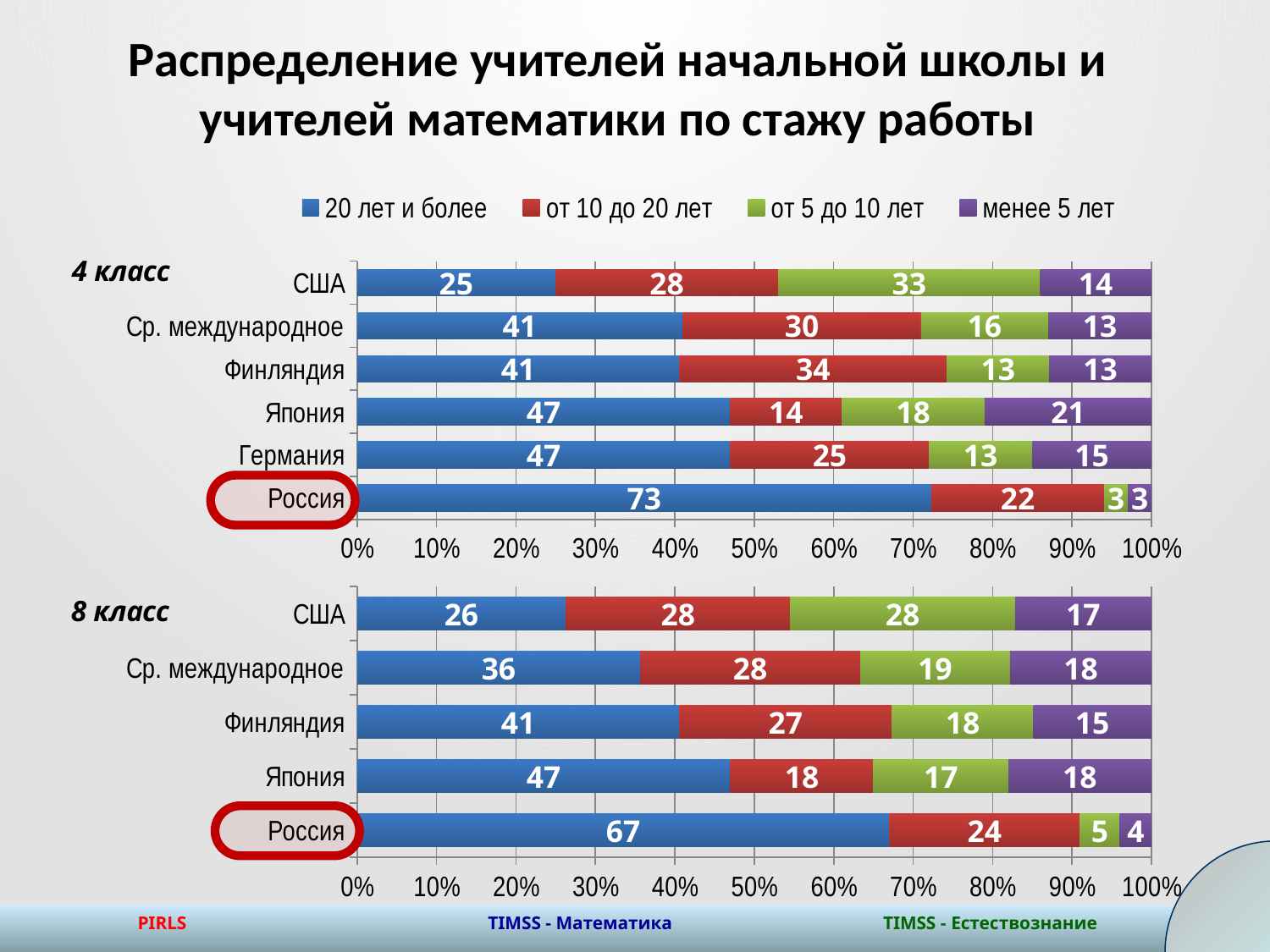
In the 4 класс chart, what is the difference between Россия and США in the '20 лет и более' series? 48 In the 4 класс chart, which category has the highest value in the '20 лет и более' series? Россия In the 8 класс chart, what is the value for США in the 'менее 5 лет' series? 17 What kind of chart is the 8 класс chart? Stacked bar chart In the 4 класс chart, what is the value for Россия in the '20 лет и более' series? 73 How many series does the legend list? 4 In the 8 класс chart, what is the value for Япония in the 'от 10 до 20 лет' series? 18 In the 4 класс chart, what is the value for Германия in the 'от 5 до 10 лет' series? 13 How many categories are shown in the 4 класс chart? 6 In the 8 класс chart, which has the larger value in the '20 лет и более' series: Финляндия or Ср. международное? Финляндия In the 8 класс chart, which category has the lowest value in the 'менее 5 лет' series? Россия In the 8 класс chart, what is the total of the stacked bar for Россия? 100